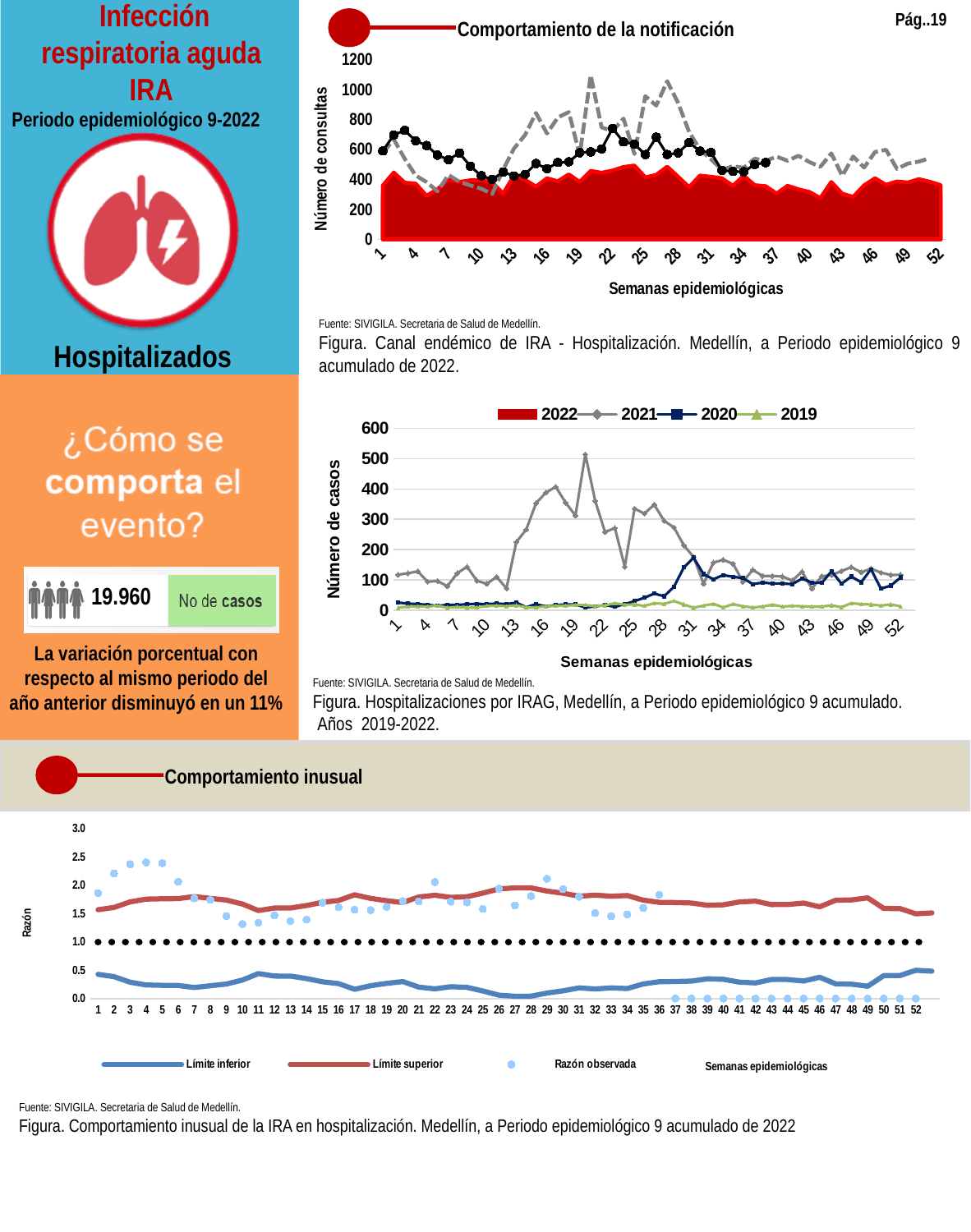
In the bottom chart (Comportamiento inusual), how many series does the legend list? 3 In the middle chart (Hospitalizaciones por IRAG), how many series does the legend list? 4 How many epidemiological weeks are shown on the x axis of the bottom chart (Comportamiento inusual)? 52 In the middle chart (Hospitalizaciones por IRAG), is the value for 2019 at week 31 greater or less than 100? less In the middle chart (Hospitalizaciones por IRAG), is the value for 2021 at week 19 greater or less than 400? less What is the y-axis title of the top chart (Comportamiento de la notificación)? Número de consultas In the bottom chart (Comportamiento inusual), is the Razón observada at week 45 greater or less than 0.5? less What kind of chart is the middle chart (Hospitalizaciones por IRAG)? Combination bar and line chart In the middle chart (Hospitalizaciones por IRAG), at week 19, which series is larger: 2021 or 2020? 2021 In the middle chart (Hospitalizaciones por IRAG), which year's series reaches the highest peak? 2021